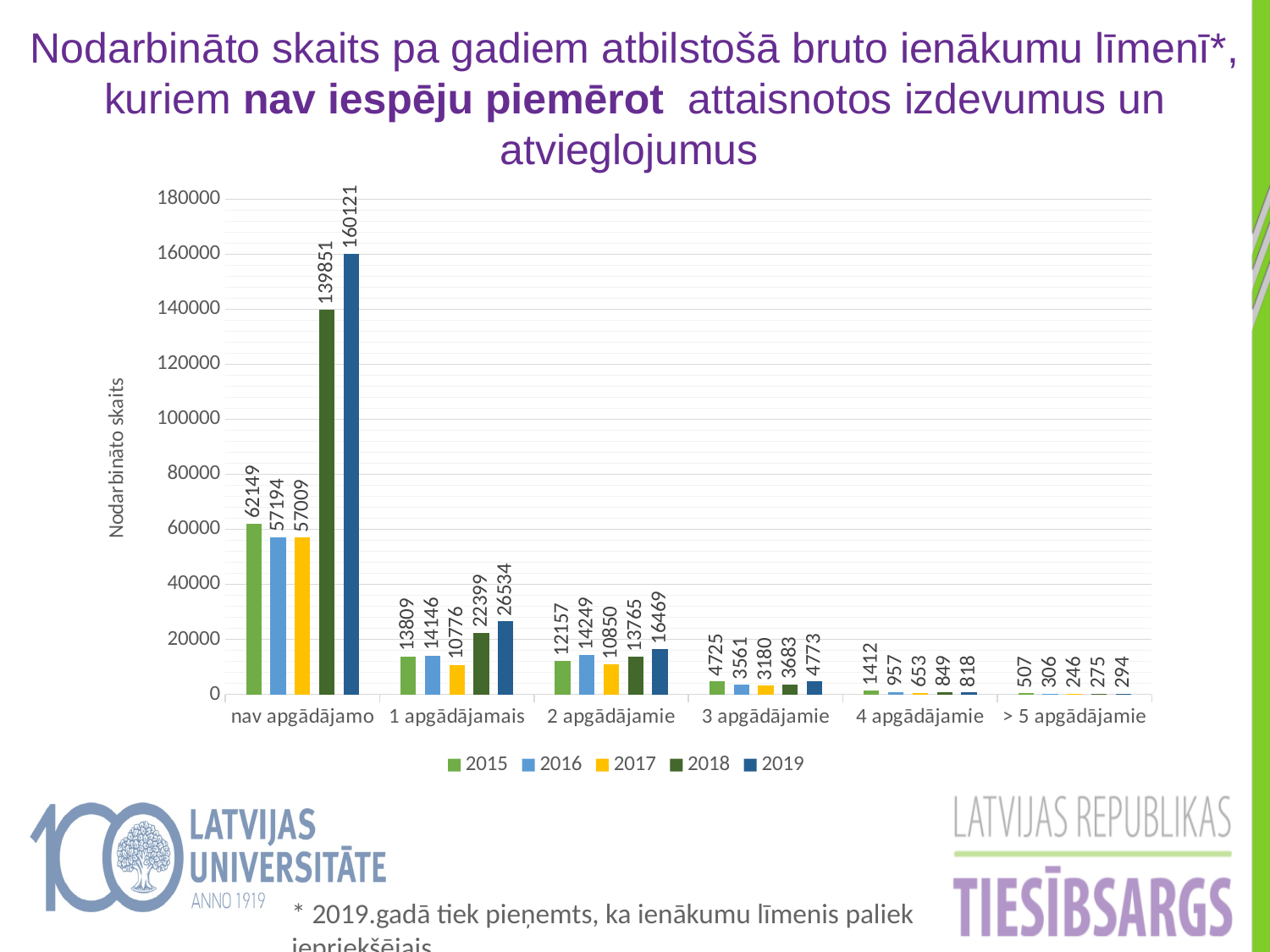
What is the value for 2019 in the 'nav apgādājamo' category? 160121 What is the label of the vertical axis? Nodarbināto skaits How many series does the legend list? 5 What is the difference between the 2019 and 2018 values in the 'nav apgādājamo' category? 20270 How many categories are shown on the x axis? 6 What is the value for 2016 in the '2 apgādājamie' category? 14249 What is the value for 2017 in the '1 apgādājamais' category? 10776 Which year has the lowest value in the '> 5 apgādājamie' category? 2017 What kind of chart is shown on the slide? bar chart Which year has the highest value in the 'nav apgādājamo' category? 2019 What is the value for 2015 in the '4 apgādājamie' category? 1412 Which is larger in the '3 apgādājamie' category: the 2015 value or the 2019 value? 2019